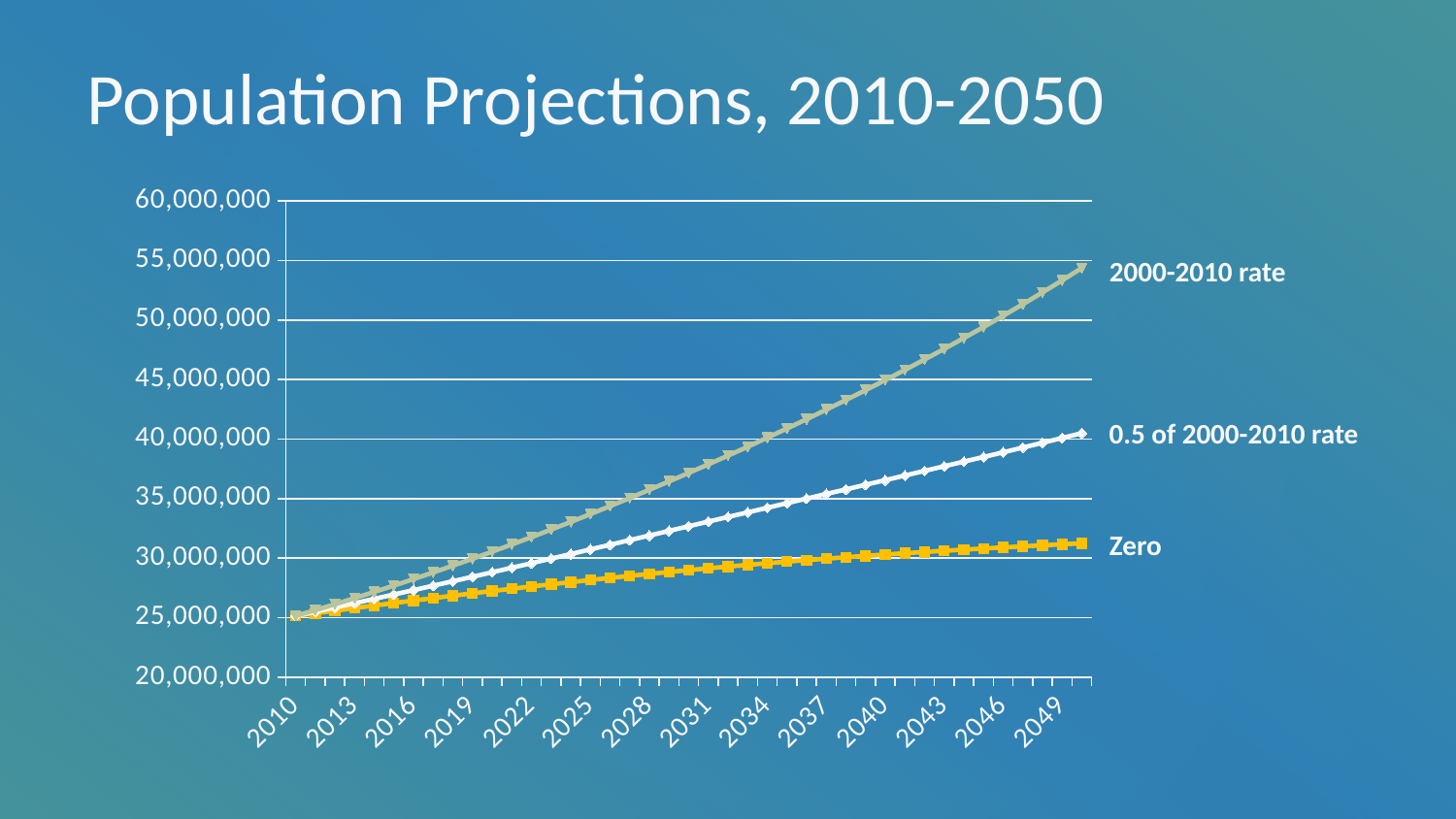
What is the highest value shown on the vertical axis? 60,000,000 What kind of chart is shown on the slide? line chart What is the title of the slide? Population Projections, 2010-2050 In 2040, which series has the larger value, '2000-2010 rate' or 'Zero'? 2000-2010 rate Does the '2000-2010 rate' series rise or fall from 2010 to 2050? rise Is the value for the '0.5 of 2000-2010 rate' series in 2050 greater or less than 45,000,000? less Which series has the lowest value in 2050? Zero How many series are plotted on the chart? 3 Is the value for the '2000-2010 rate' series in 2050 greater or less than 50,000,000? greater Which series has the highest value in 2050? 2000-2010 rate Is the value for the '2000-2010 rate' series in 2040 greater or less than 40,000,000? greater